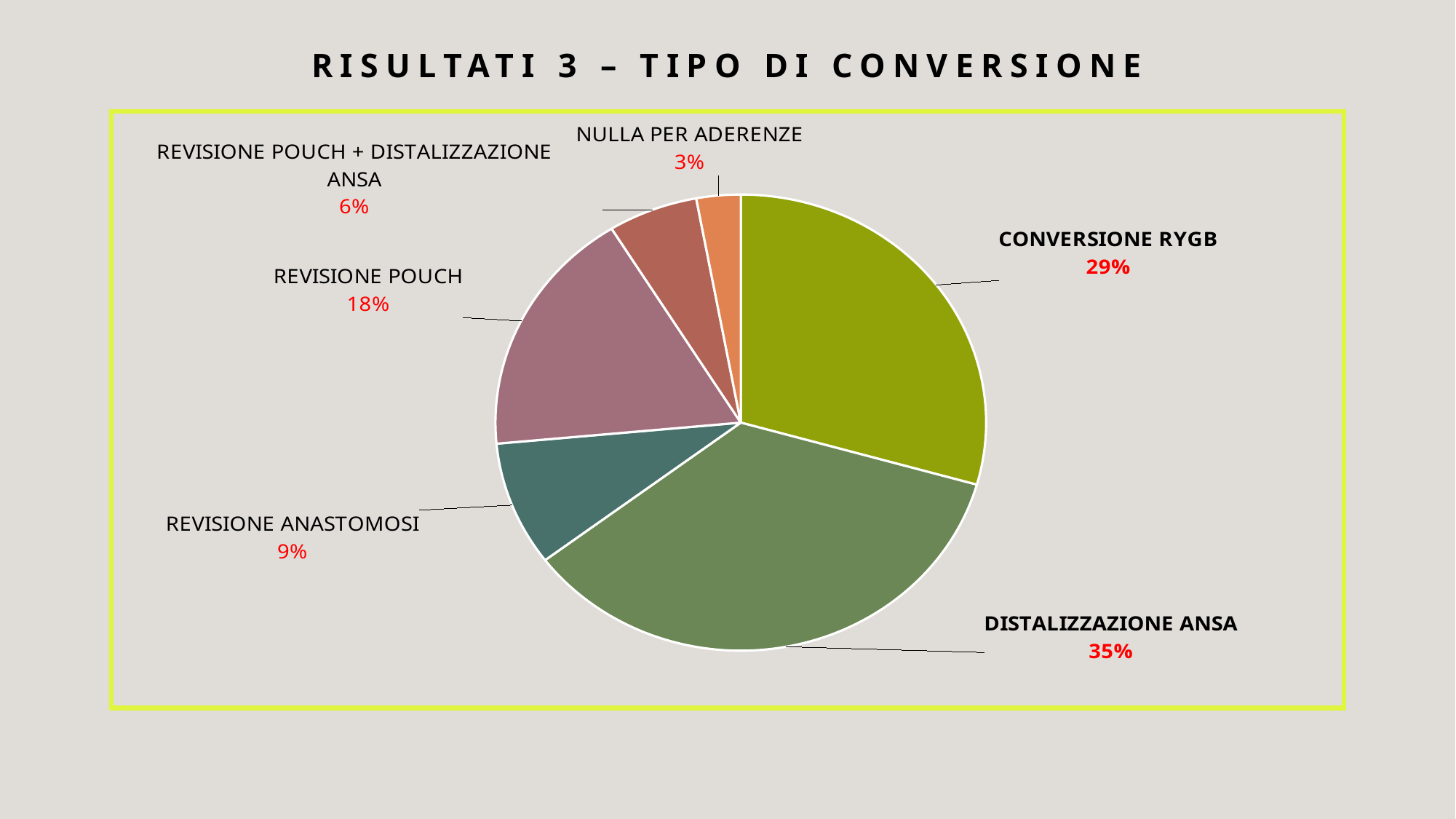
Which is larger, REVISIONE POUCH or REVISIONE ANASTOMOSI? REVISIONE POUCH Which category has the smallest slice of the pie? NULLA PER ADERENZE What is the title of the slide? RISULTATI 3 – TIPO DI CONVERSIONE What share of the pie does DISTALIZZAZIONE ANSA have? 35% What is the value for REVISIONE ANASTOMOSI? 9% How many categories are shown in the pie chart? 6 What share of the pie does CONVERSIONE RYGB have? 29% What kind of chart is shown on the slide? pie chart What is the difference between DISTALIZZAZIONE ANSA and CONVERSIONE RYGB? 6% What is the value for NULLA PER ADERENZE? 3% What is the value for REVISIONE POUCH? 18% Which category has the largest slice of the pie? DISTALIZZAZIONE ANSA